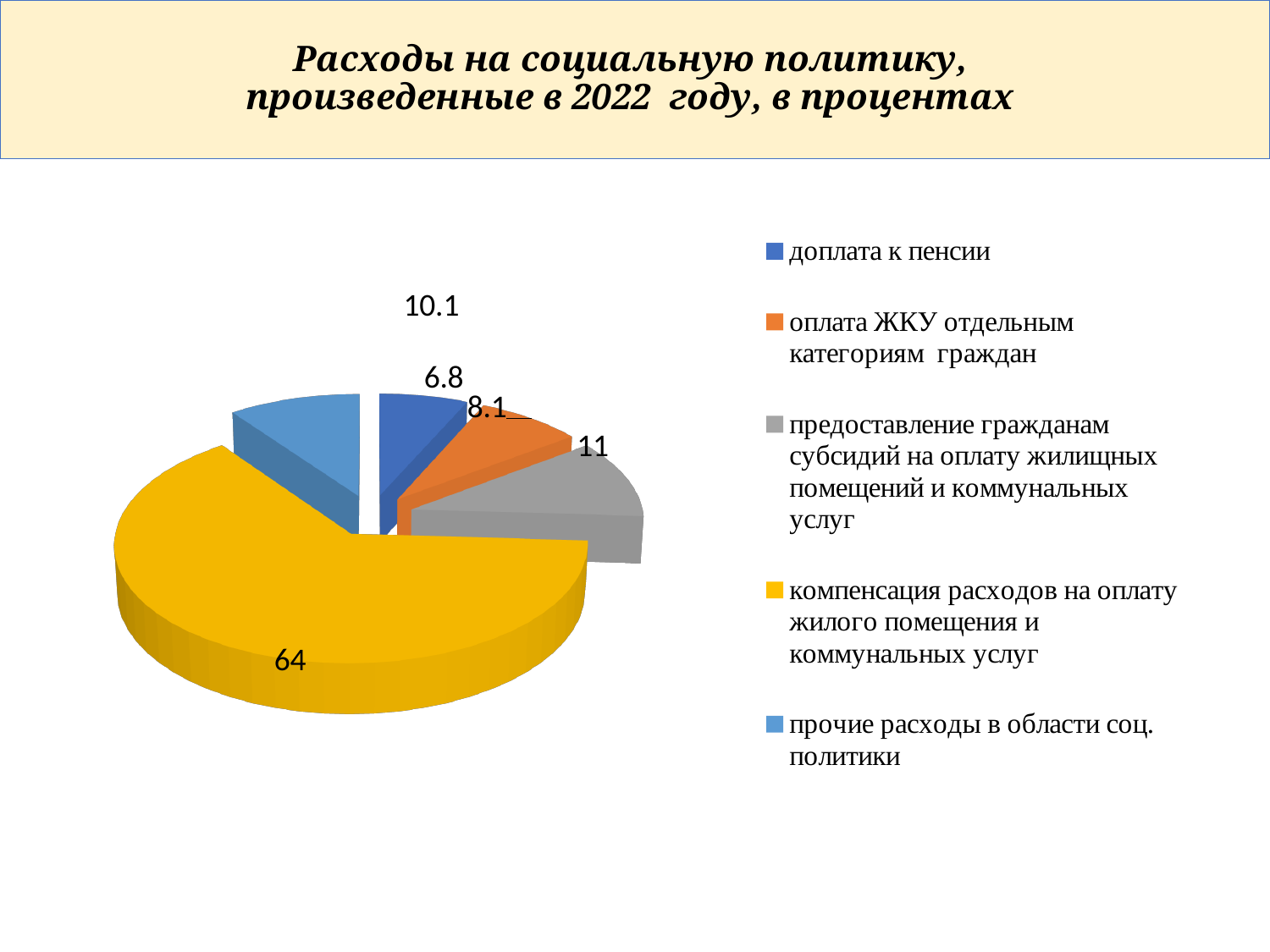
What is the value for "доплата к пенсии"? 6.8 What is the value for "предоставление гражданам субсидий на оплату жилищных помещений и коммунальных услуг"? 11 What colour is the slice for "компенсация расходов на оплату жилого помещения и коммунальных услуг"? yellow Which category has the smallest share of the pie? доплата к пенсии What kind of chart is shown on the slide? pie chart What is the value for "компенсация расходов на оплату жилого помещения и коммунальных услуг"? 64 What is the value for "оплата ЖКУ отдельным категориям граждан"? 8.1 What is the difference between the values for "компенсация расходов на оплату жилого помещения и коммунальных услуг" and "предоставление гражданам субсидий на оплату жилищных помещений и коммунальных услуг"? 53 How many slices does the pie chart have? 5 Which is larger: the value for "прочие расходы в области соц. политики" or the value for "оплата ЖКУ отдельным категориям граждан"? прочие расходы в области соц. политики Which category has the largest share of the pie? компенсация расходов на оплату жилого помещения и коммунальных услуг What is the value for "прочие расходы в области соц. политики"? 10.1